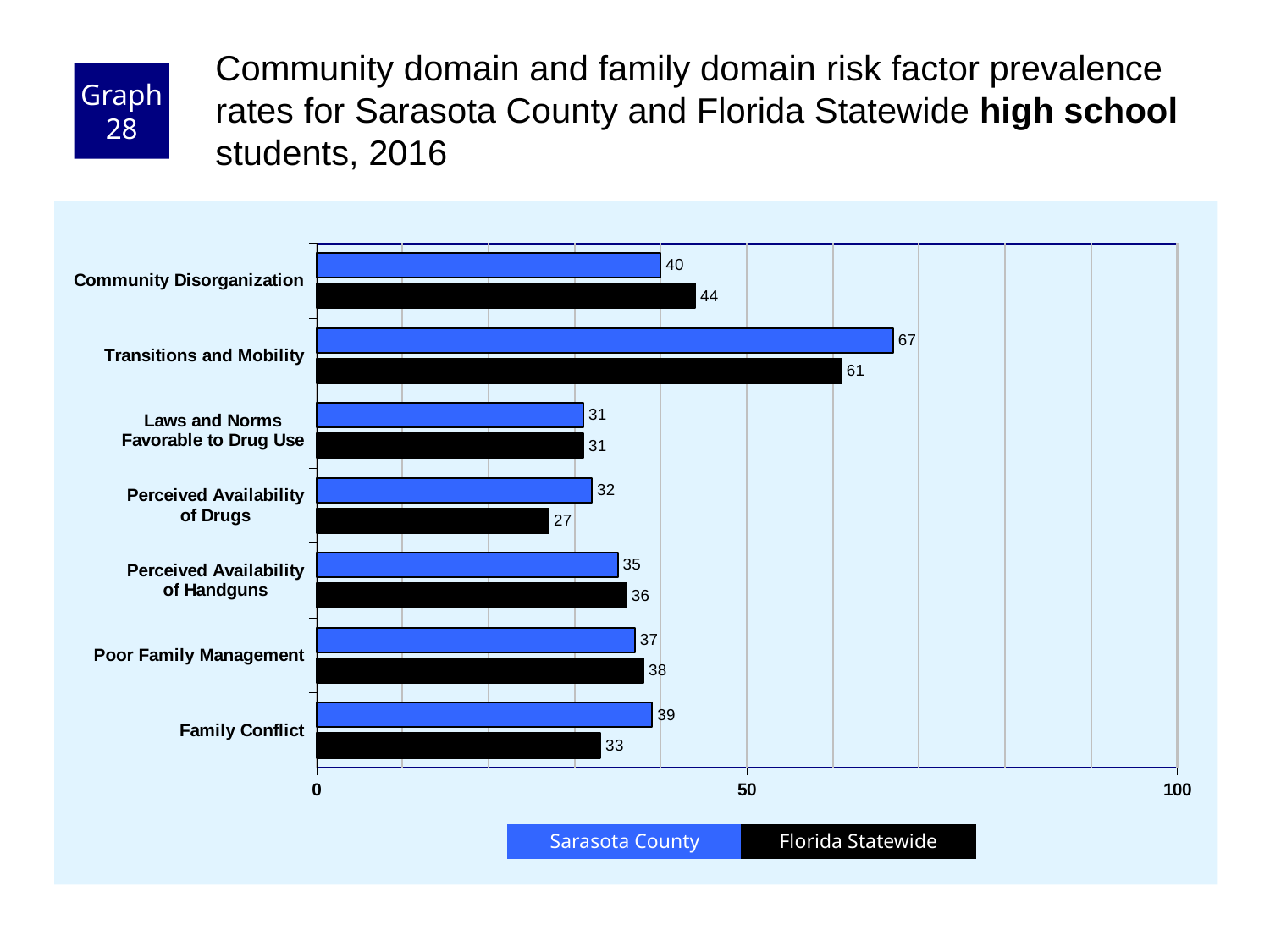
Which risk factor has the highest Sarasota County value? Transitions and Mobility How many risk factors are shown on the chart? 7 What is the Florida Statewide value for Family Conflict? 33 How many series does the legend list? 2 For Family Conflict, which is larger: the Sarasota County value or the Florida Statewide value? Sarasota County What is the difference between the Florida Statewide and Sarasota County values for Community Disorganization? 4 What is the Sarasota County value for Transitions and Mobility? 67 What is the difference between the Sarasota County and Florida Statewide values for Transitions and Mobility? 6 What is the Florida Statewide value for Perceived Availability of Drugs? 27 What kind of chart is shown on the slide? Bar chart Is the Sarasota County value for Transitions and Mobility greater or less than 50? greater Which risk factor has the lowest Florida Statewide value? Perceived Availability of Drugs